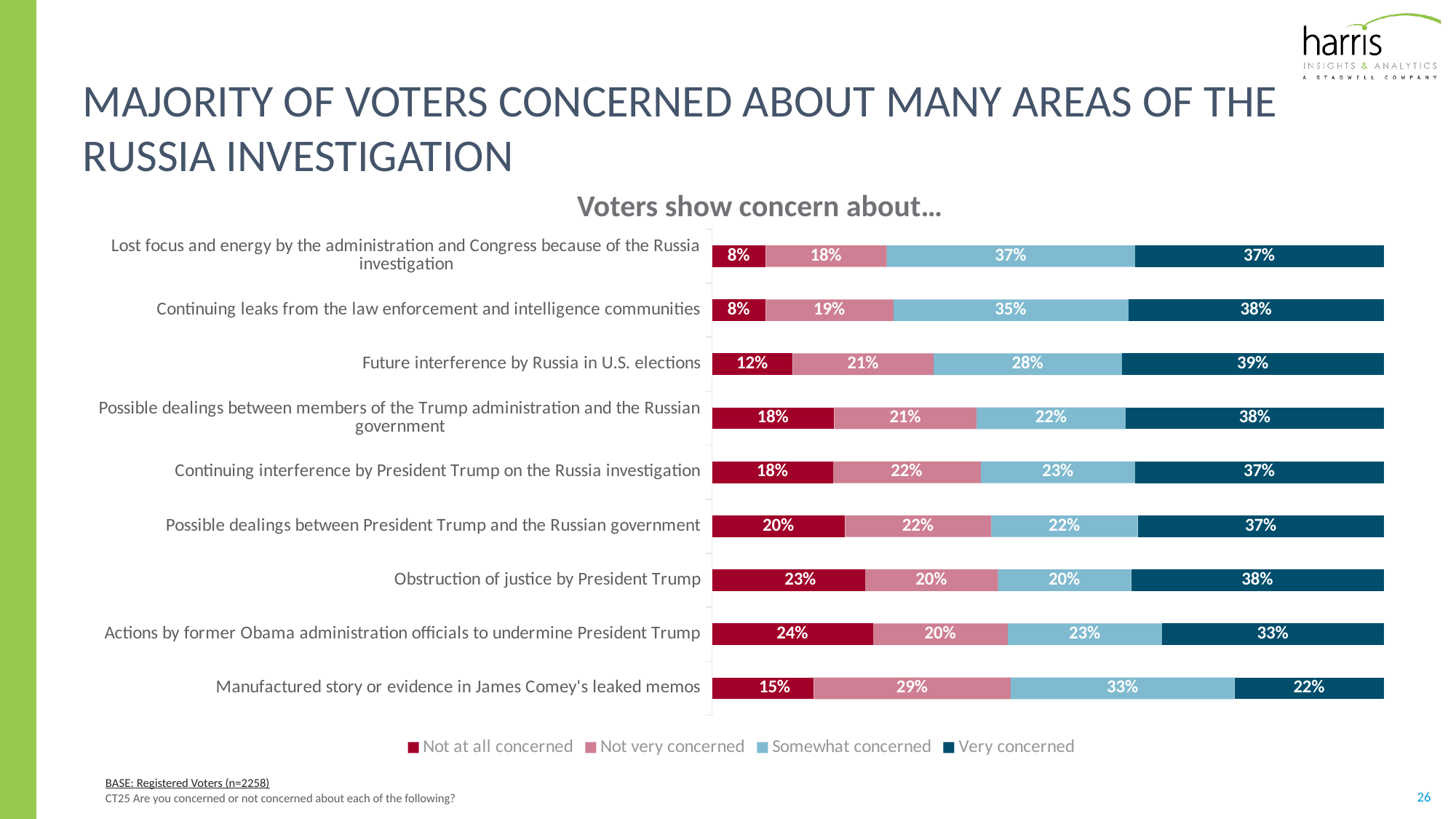
What percentage of voters are somewhat concerned about a manufactured story or evidence in James Comey's leaked memos? 33% What is the total of the four segments for the bar on future interference by Russia in U.S. elections? 100% Which has a larger very concerned share: continuing leaks from the law enforcement and intelligence communities, or actions by former Obama administration officials to undermine President Trump? Continuing leaks from the law enforcement and intelligence communities What is the difference in percentage points between the very concerned share for future interference by Russia in U.S. elections and for the James Comey leaked memos item? 17 percentage points How many series does the legend list? 4 What percentage of voters are not at all concerned about actions by former Obama administration officials to undermine President Trump? 24% What percentage of voters are very concerned about future interference by Russia in U.S. elections? 39% How many items (categories) are shown in the chart? 9 Which item has the highest share of voters who are very concerned? Future interference by Russia in U.S. elections Which item has the highest share of voters who are not at all concerned? Actions by former Obama administration officials to undermine President Trump What type of chart is shown on the slide? Stacked bar chart Which item has the lowest share of voters who are very concerned? Manufactured story or evidence in James Comey's leaked memos